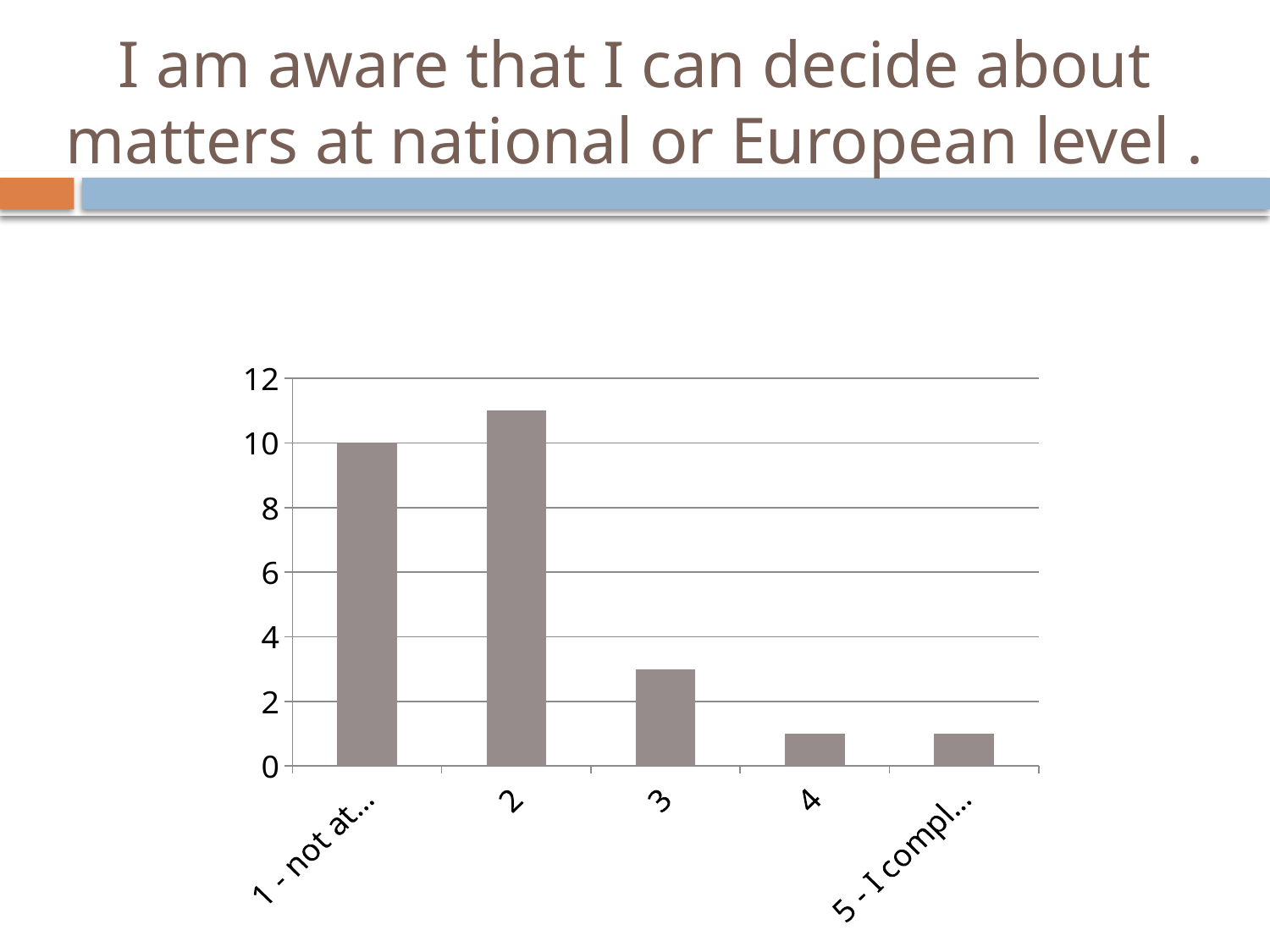
Is the value for "5 - I compl..." greater or less than 2? less Which category has the highest bar? 2 Is the value for category 3 greater or less than 4? less Which is larger, the value for category 2 or the value for category 3? 2 Is the value for category 2 greater or less than 10? greater What is the highest value shown on the vertical axis? 12 Which is larger, the value for "1 - not at..." or the value for category 4? 1 - not at... What is the value for the category "1 - not at..."? 10 How many categories are shown on the x axis of the chart? 5 What kind of chart is shown on the slide? bar chart Do the values rise or fall from category 2 to category 4? fall